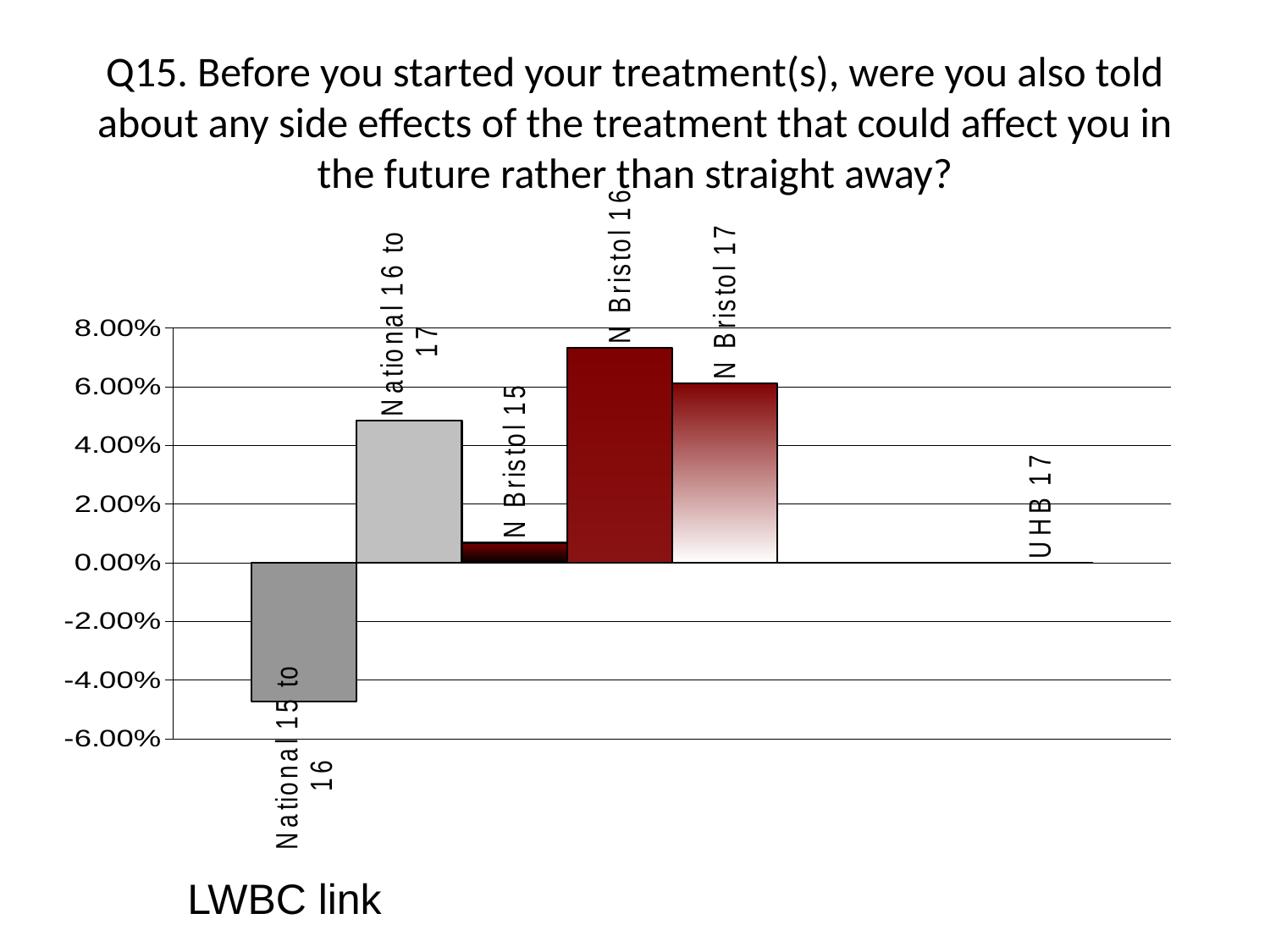
What kind of chart is shown on the slide? bar chart Which category has the lowest value in the chart? National 15 to 16 How many categories are labelled on the x axis of the chart? 6 How many categories in the chart have a negative value? 1 Which category has the highest value in the chart? N Bristol 16 Which is larger, the value for N Bristol 16 or the value for N Bristol 17? N Bristol 16 Is the value for N Bristol 16 greater or less than 6.00%? greater Is the value for N Bristol 15 greater or less than 2.00%? less Is the value for National 15 to 16 greater or less than -4.00%? less What question number is referenced in the chart title? Q15